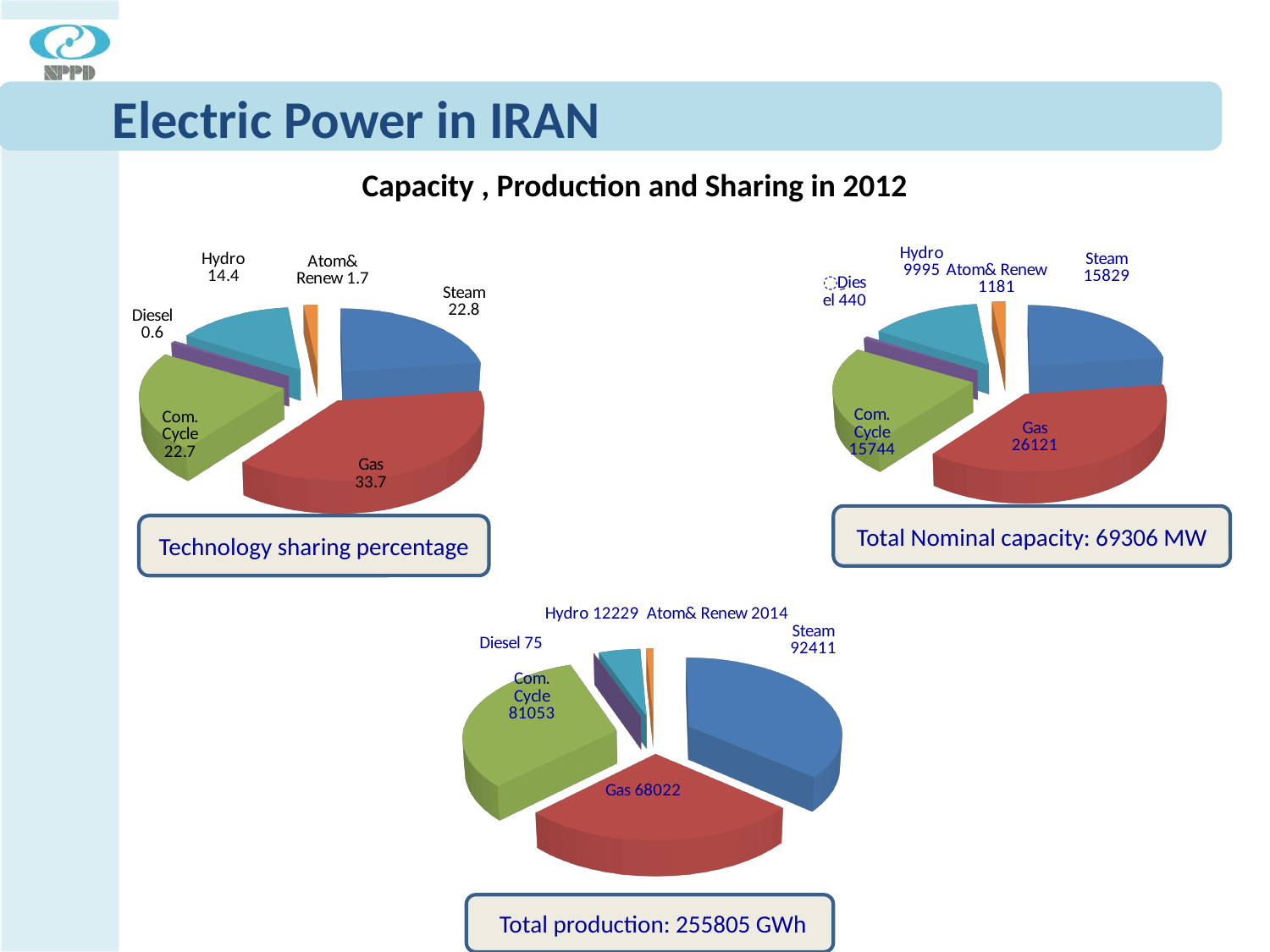
What total production is stated below the bottom pie chart? 255805 GWh In the top-right pie chart (Total Nominal capacity), what is the difference between Gas and Steam? 10292 In the top-left pie chart (Technology sharing percentage), which category has the smallest share? Diesel In the top-left pie chart (Technology sharing percentage), what is the value for Gas? 33.7 In the bottom pie chart (Total production), which is larger, Com. Cycle or Gas? Com. Cycle In the bottom pie chart (Total production), what is the value for Diesel? 75 How many slices does the bottom pie chart (Total production) have? 6 In the top-left pie chart (Technology sharing percentage), what is the difference between Steam and Com. Cycle? 0.1 In the bottom pie chart (Total production), what is the value for Steam? 92411 In the top-right pie chart (Total Nominal capacity), which category has the largest value? Gas In the top-right pie chart (Total Nominal capacity), what is the value for Com. Cycle? 15744 What type of chart is used for the Technology sharing percentage? Pie chart